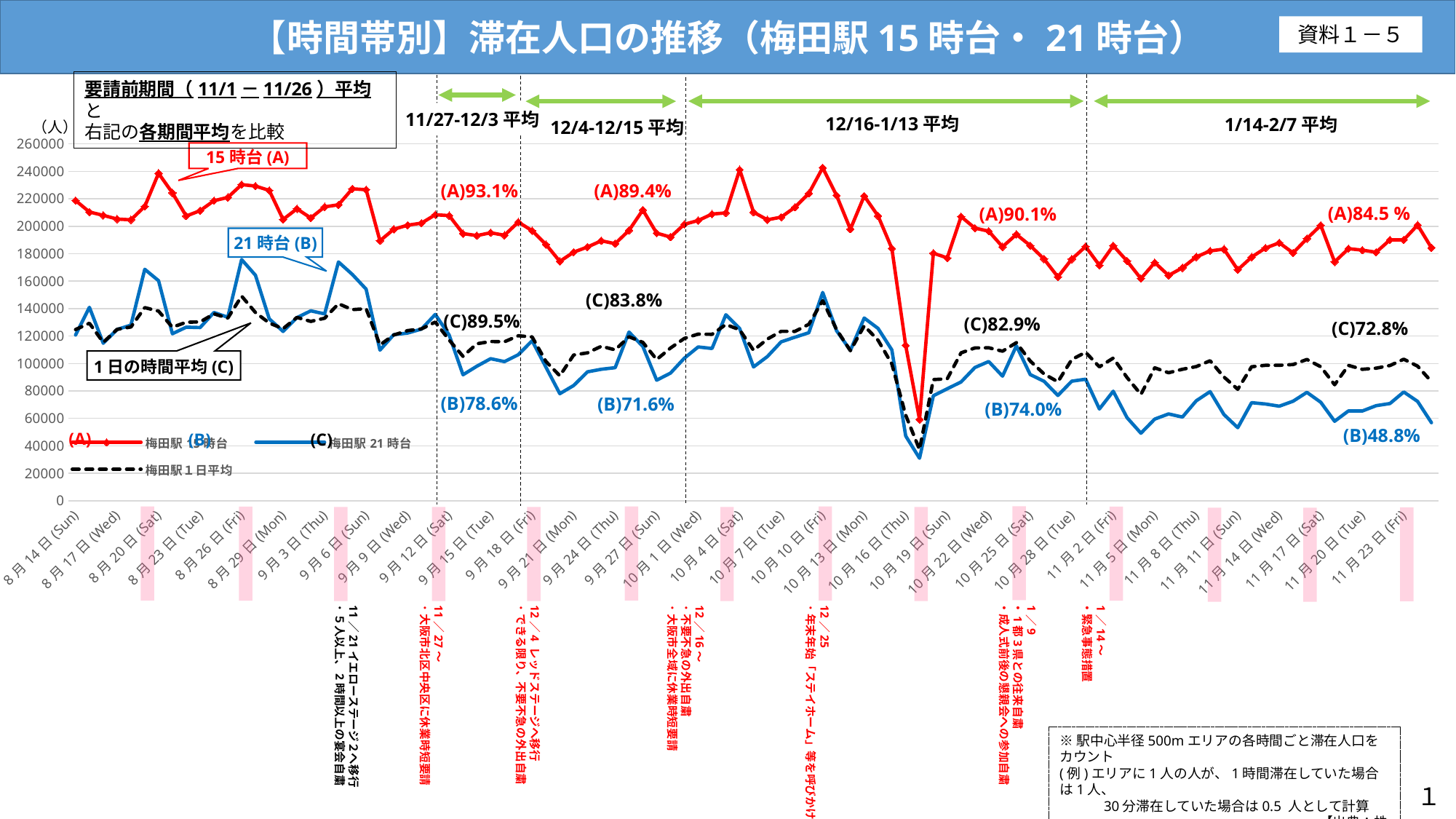
Which is larger in the 12/16-1/13 平均 period, the (A) percentage or the (C) percentage? (A) 90.1% What is the (A) percentage annotated for the 11/27-12/3 平均 period? 93.1% Is the value of the 梅田駅15時台 line at 8月20日 (Sat) greater or less than 220000? greater What kind of chart is shown on the slide? line chart What is the (B) percentage annotated for the 1/14-2/7 平均 period? 48.8% How many series does the legend list? 3 Which series is plotted as a black dashed line? 梅田駅1日平均 What is the (B) percentage annotated for the 12/4-12/15 平均 period? 71.6% What is the difference between the (A) and (B) percentages in the 11/27-12/3 平均 period? 14.5 percentage points Which of the four comparison periods has the lowest (B) percentage? 1/14-2/7 平均 What is the (C) percentage annotated for the 12/16-1/13 平均 period? 82.9% Which of the four comparison periods has the highest (A) percentage? 11/27-12/3 平均